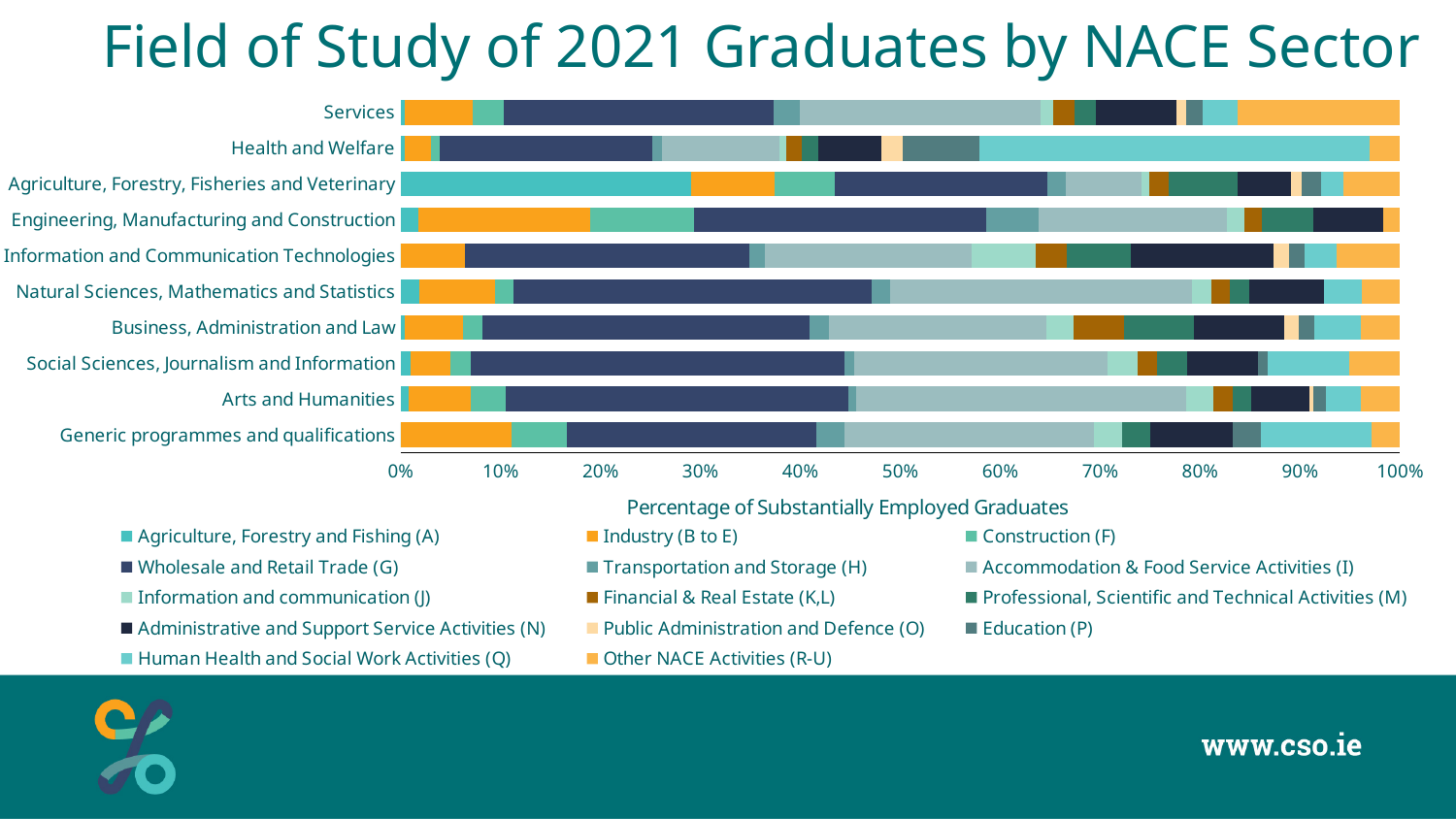
What is the title of the chart? Field of Study of 2021 Graduates by NACE Sector Which field of study has the largest Human Health and Social Work Activities (Q) share? Health and Welfare Is the Human Health and Social Work Activities (Q) share for Health and Welfare graduates greater or less than 30%? greater Is the Agriculture, Forestry and Fishing (A) share for Agriculture, Forestry, Fisheries and Veterinary graduates greater or less than 20%? greater What is the label on the horizontal axis of the chart? Percentage of Substantially Employed Graduates How many NACE sectors does the legend list? 14 Is the Information and communication (J) share for Information and Communication Technologies graduates greater or less than 10%? less How many fields of study are plotted on the chart? 10 Is the Wholesale and Retail Trade (G) share larger for Business, Administration and Law or for Health and Welfare? Business, Administration and Law Which field of study has the largest Agriculture, Forestry and Fishing (A) share? Agriculture, Forestry, Fisheries and Veterinary What kind of chart is shown on the slide? Stacked bar chart